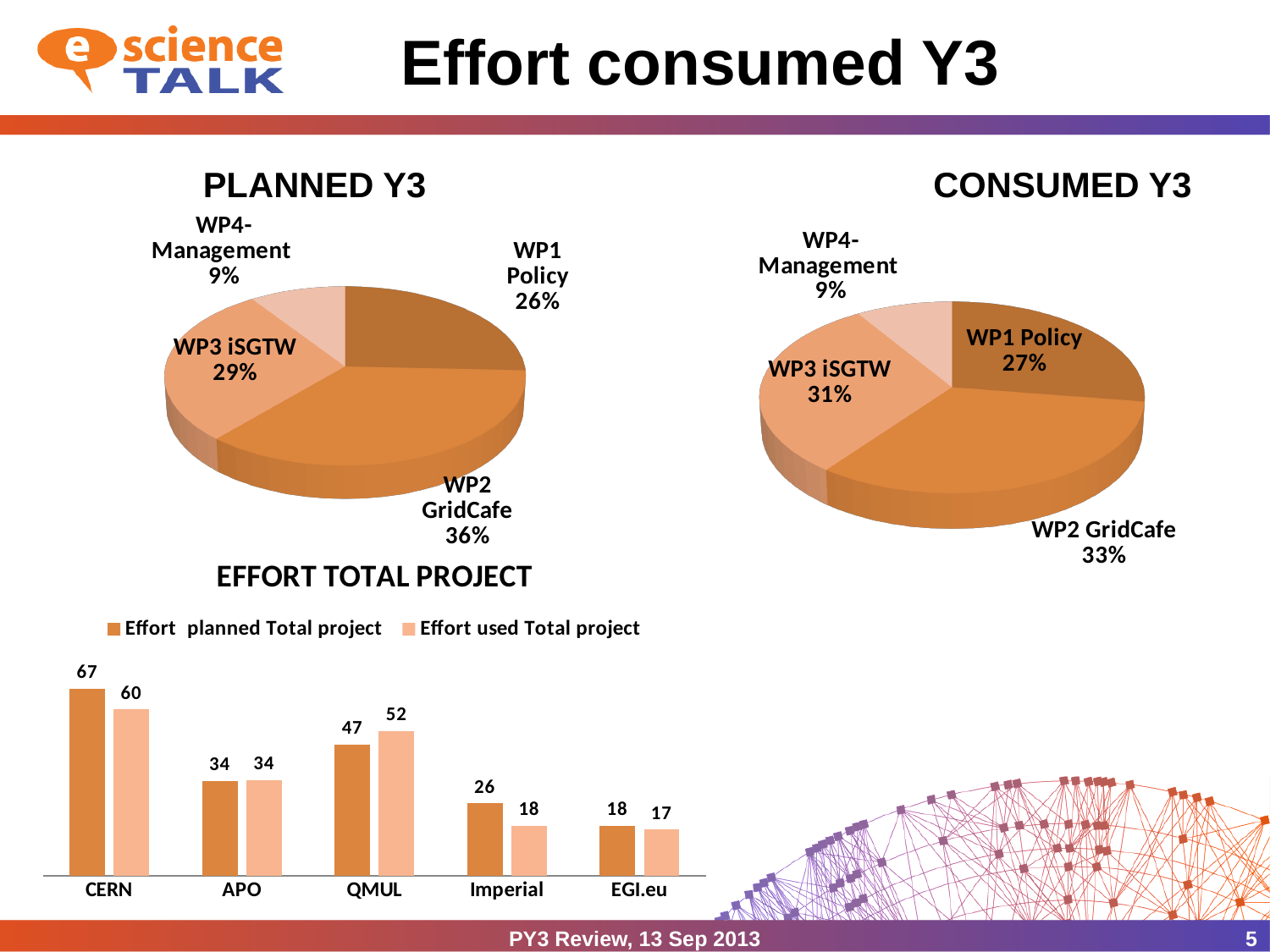
In the PLANNED Y3 pie chart, what share does WP2 GridCafe have? 36% How many slices does the PLANNED Y3 pie chart have? 4 In the PLANNED Y3 pie chart, which work package has the smallest share? WP4-Management In the CONSUMED Y3 pie chart, which work package has the largest share? WP2 GridCafe In the EFFORT TOTAL PROJECT chart, what is the difference between Effort planned and Effort used for Imperial? 8 In the CONSUMED Y3 pie chart, what share does WP3 iSGTW have? 31% In the EFFORT TOTAL PROJECT chart, what is the Effort used Total project value for QMUL? 52 In the CONSUMED Y3 pie chart, what is the share for WP1 Policy? 27% How many series does the legend of the EFFORT TOTAL PROJECT chart list? 2 What type of chart is the EFFORT TOTAL PROJECT chart? Bar chart In the EFFORT TOTAL PROJECT chart, which partner has the lowest Effort used Total project value? EGI.eu In the EFFORT TOTAL PROJECT chart, what is the Effort planned Total project value for CERN? 67